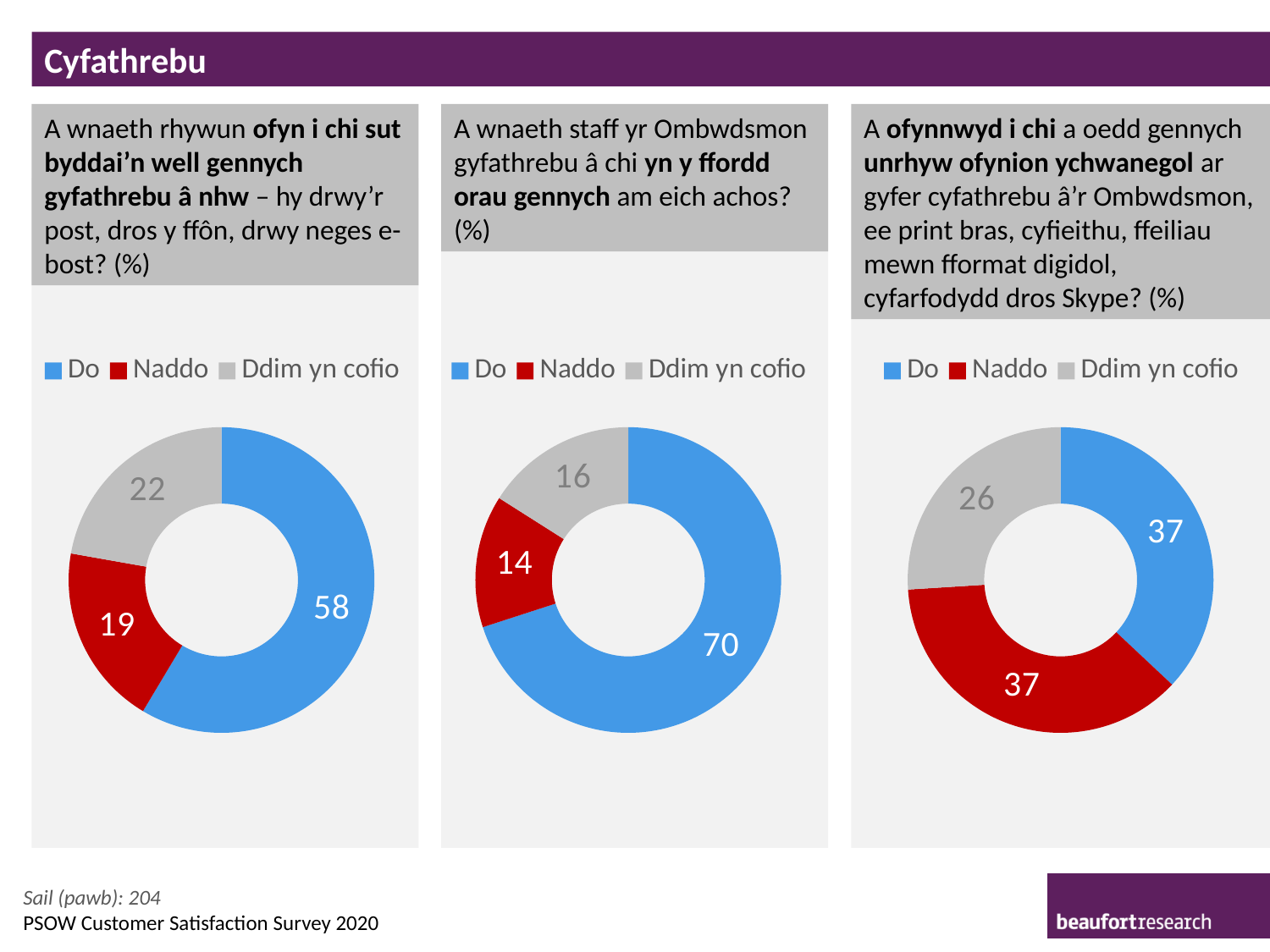
In the left-hand chart, which category has the lowest value? Naddo In the left-hand chart, what is the difference between the values for "Do" and "Naddo"? 39 In the middle chart, what is the value for "Naddo"? 14 In the right-hand chart, what colour is the "Naddo" segment? Red In the right-hand chart, which category has the lowest value? Ddim yn cofio In the middle chart, which category has the highest value? Do In the middle chart, what is the difference between the values for "Ddim yn cofio" and "Naddo"? 2 How many series does the legend of the middle chart list? 3 In the right-hand chart, what is the value for "Ddim yn cofio"? 26 In the left-hand chart, which is larger: the value for "Ddim yn cofio" or the value for "Naddo"? Ddim yn cofio What kind of chart is the right-hand chart? Doughnut chart In the left-hand chart, what is the value for "Do"? 58